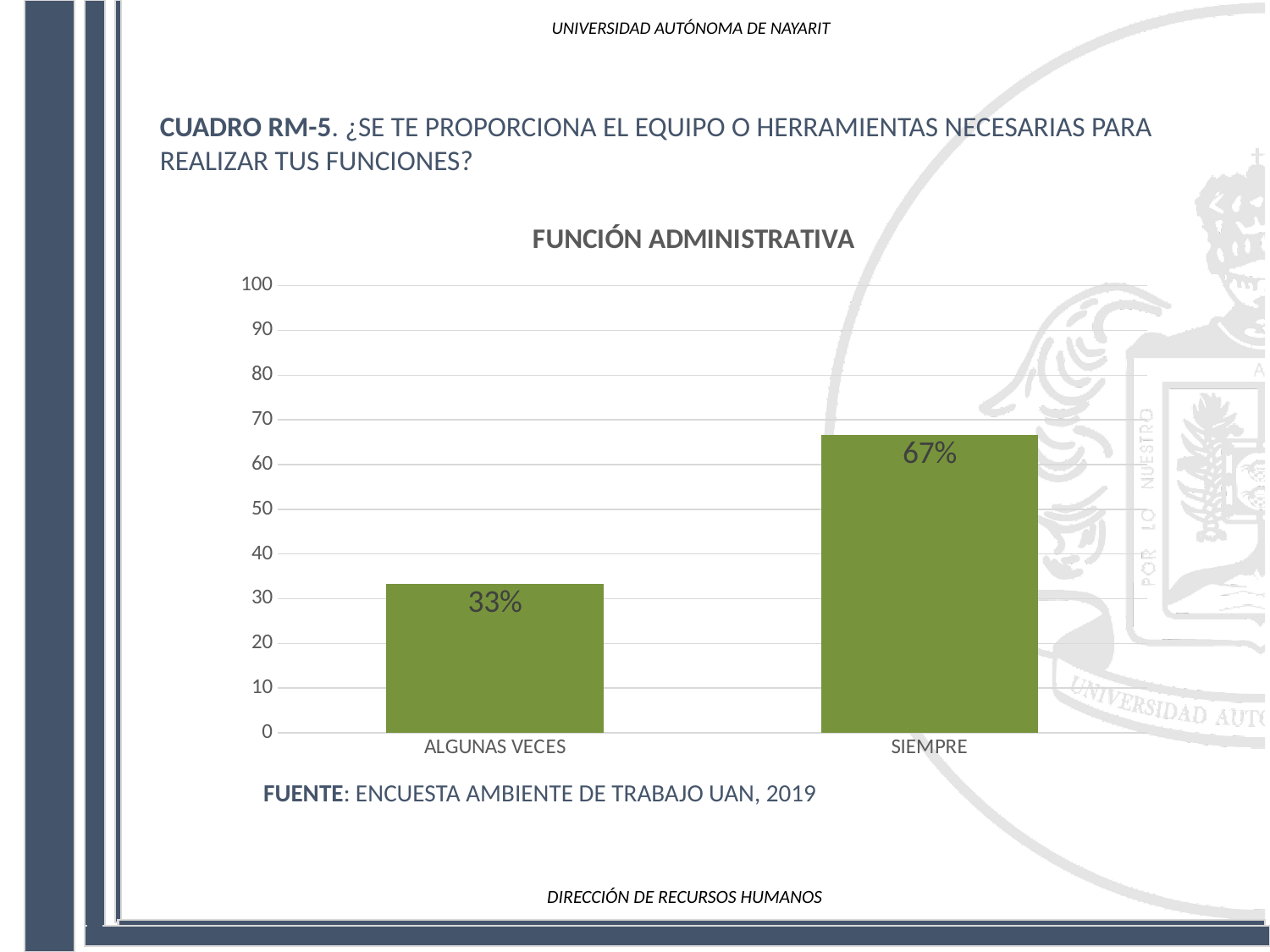
What is the title of the chart? FUNCIÓN ADMINISTRATIVA What is the highest value shown on the y axis? 100 Is the value for SIEMPRE greater or less than 50? greater Is the value for ALGUNAS VECES greater or less than 40? less Which category has the highest value? SIEMPRE What is the value for SIEMPRE? 67% What is the difference between the values for SIEMPRE and ALGUNAS VECES? 34% Which is larger, the value for ALGUNAS VECES or the value for SIEMPRE? SIEMPRE How many categories are shown on the x axis? 2 Which category has the lowest value? ALGUNAS VECES What is the value for ALGUNAS VECES? 33% What kind of chart is shown on the slide? Bar chart